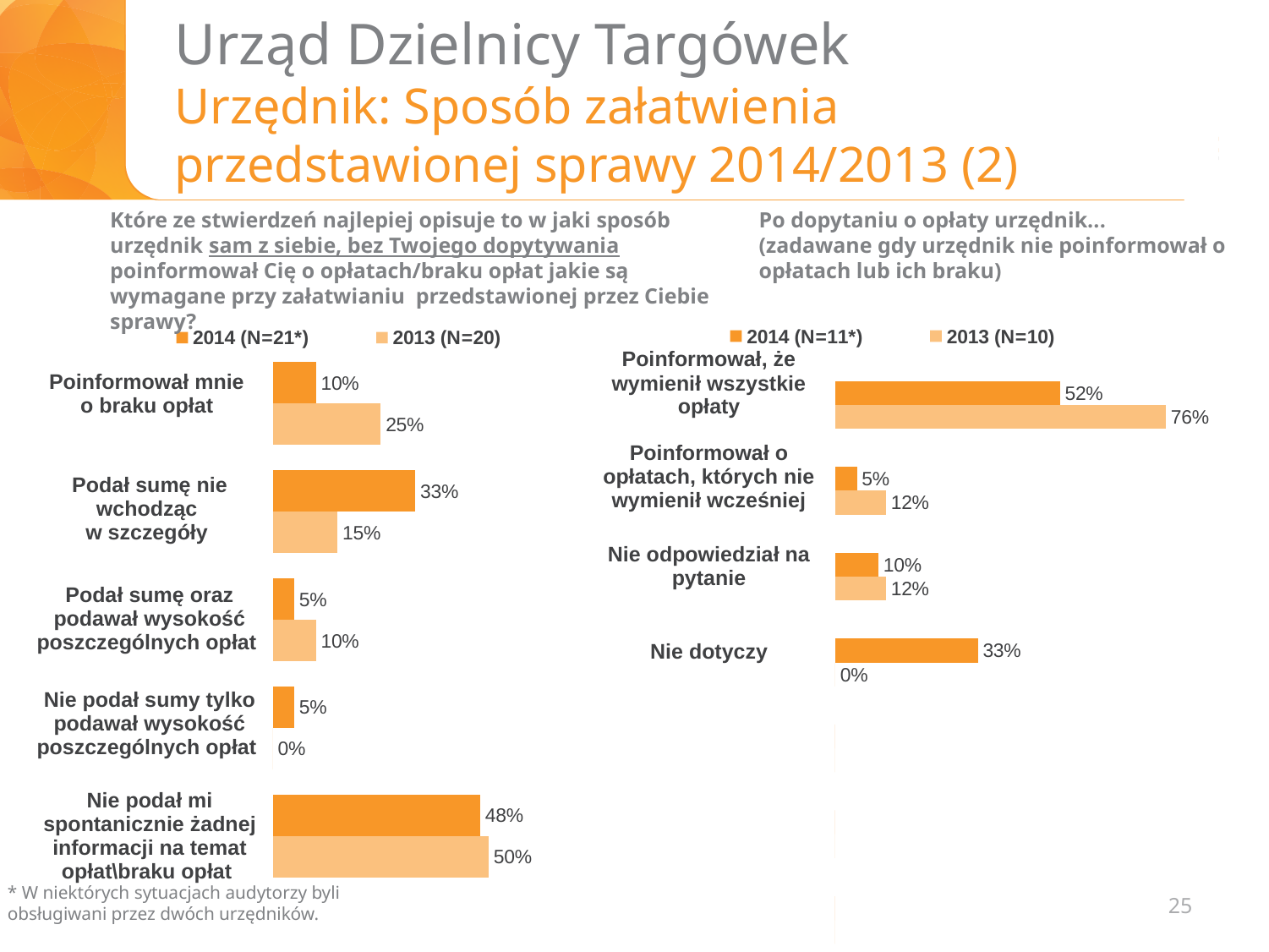
In the right chart, what is the difference between the 2013 and 2014 values for "Poinformował, że wymienił wszystkie opłaty"? 24 percentage points In the right chart, what is the 2013 value for "Poinformował, że wymienił wszystkie opłaty"? 76% In the left chart, which category has the lowest 2013 value? Nie podał sumy tylko podawał wysokość poszczególnych opłat In the left chart, what is the difference between the 2014 and 2013 values for "Podał sumę nie wchodząc w szczegóły"? 18 percentage points In the left chart, what is the 2014 value for "Nie podał mi spontanicznie żadnej informacji na temat opłat\braku opłat"? 48% In the left chart, which category has the highest 2014 value? Nie podał mi spontanicznie żadnej informacji na temat opłat\braku opłat How many series does the legend of the right chart list? 2 In the right chart, which is larger for "Poinformował o opłatach, których nie wymienił wcześniej": the 2014 value or the 2013 value? 2013 In the right chart, what is the 2014 value for "Nie dotyczy"? 33% In the left chart, what is the 2013 value for "Poinformował mnie o braku opłat"? 25% What type of chart is the left chart? Bar chart In the left chart, how many categories are shown? 5